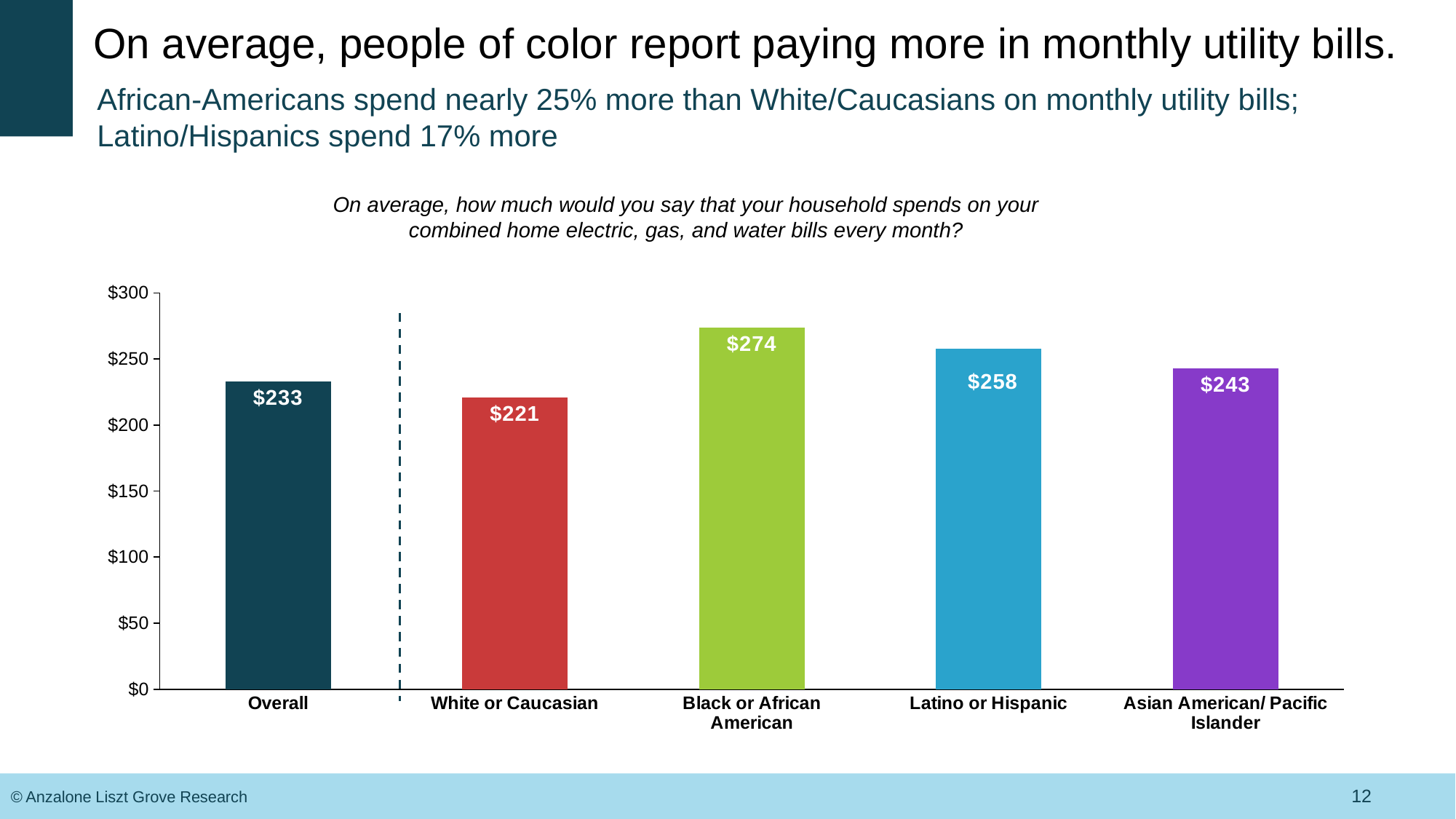
How many categories are shown on the x axis of the chart? 5 What is the average monthly utility bill reported for Black or African American households? $274 What is the value shown for Latino or Hispanic households? $258 What kind of chart is shown on the slide? bar chart Which category has the lowest average monthly utility bill? White or Caucasian Which is larger, the value for Asian American/ Pacific Islander or the value for Overall? Asian American/ Pacific Islander What is the difference between the Latino or Hispanic value and the Asian American/ Pacific Islander value? $15 What is the difference between the Black or African American value and the White or Caucasian value? $53 What is the value shown for the Overall category? $233 Which category has the highest average monthly utility bill? Black or African American Is the value for White or Caucasian greater or less than $250? less What is the maximum value shown on the y axis of the chart? $300